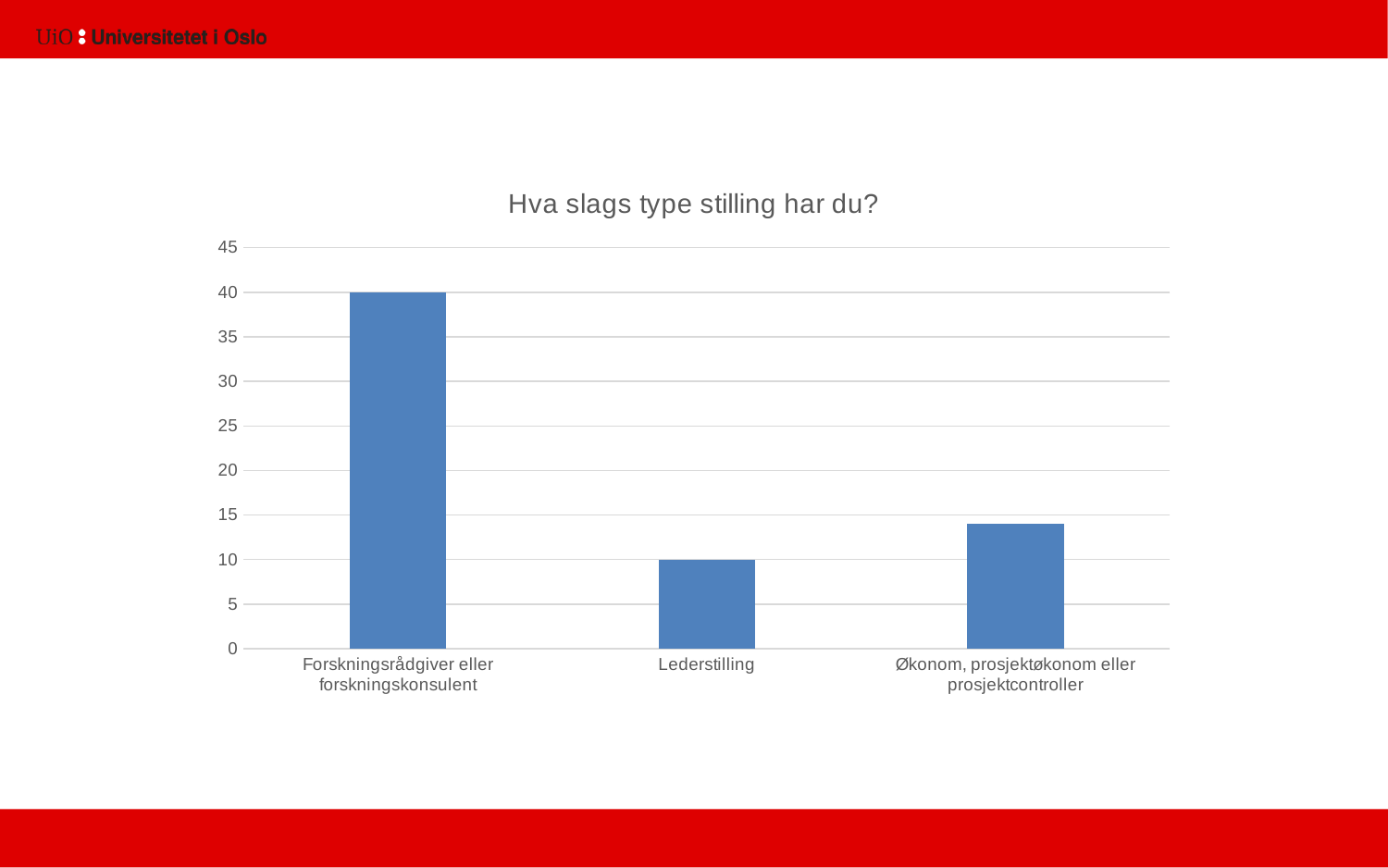
Is the value for Økonom, prosjektøkonom eller prosjektcontroller greater or less than 15? less What is the value for Lederstilling? 10 Which category has the highest value? Forskningsrådgiver eller forskningskonsulent What is the value for Forskningsrådgiver eller forskningskonsulent? 40 What is the highest value shown on the y axis? 45 What is the difference between the values for Forskningsrådgiver eller forskningskonsulent and Lederstilling? 30 Is the value for Økonom, prosjektøkonom eller prosjektcontroller greater or less than 10? greater What is the title of the chart? Hva slags type stilling har du? Which is larger, the value for Økonom, prosjektøkonom eller prosjektcontroller or the value for Lederstilling? Økonom, prosjektøkonom eller prosjektcontroller What kind of chart is shown on the slide? bar chart Which category has the lowest value? Lederstilling How many categories are shown on the x axis? 3